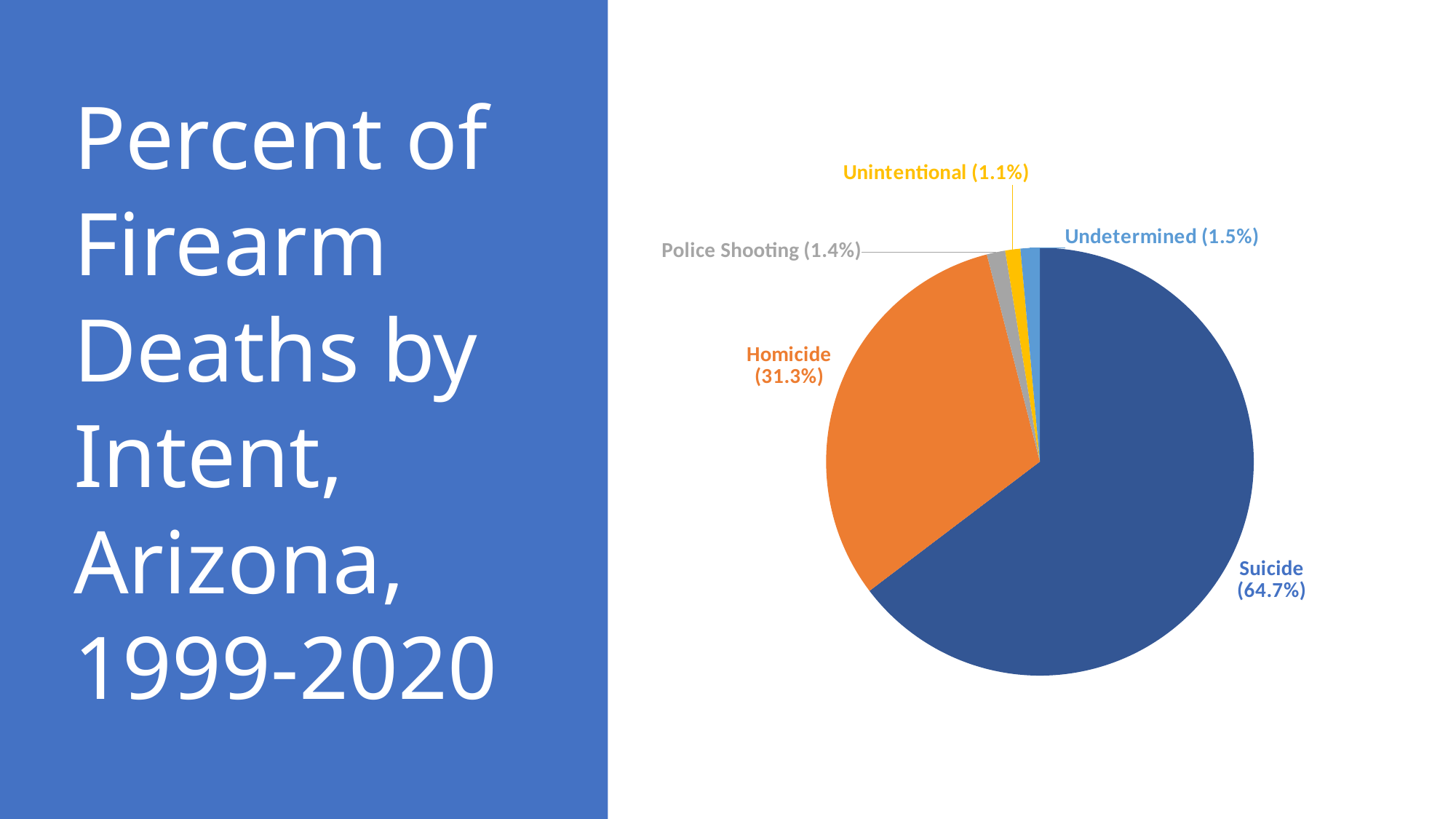
What percentage of firearm deaths in Arizona were suicides? 64.7% What share of the pie is labelled Undetermined? 1.5% What colour is the Homicide slice of the pie? Orange How many percentage points larger is the Suicide share than the Homicide share? 33.4 Which intent category accounts for the smallest share of firearm deaths? Unintentional How many intent categories are shown in the pie chart? 5 What percentage of firearm deaths in Arizona were homicides? 31.3% What kind of chart is shown on the slide? Pie chart What share of the pie is labelled Unintentional? 1.1% What share of the pie is labelled Police Shooting? 1.4% Which intent category accounts for the largest share of firearm deaths? Suicide Which is larger, the Undetermined share or the Police Shooting share? Undetermined